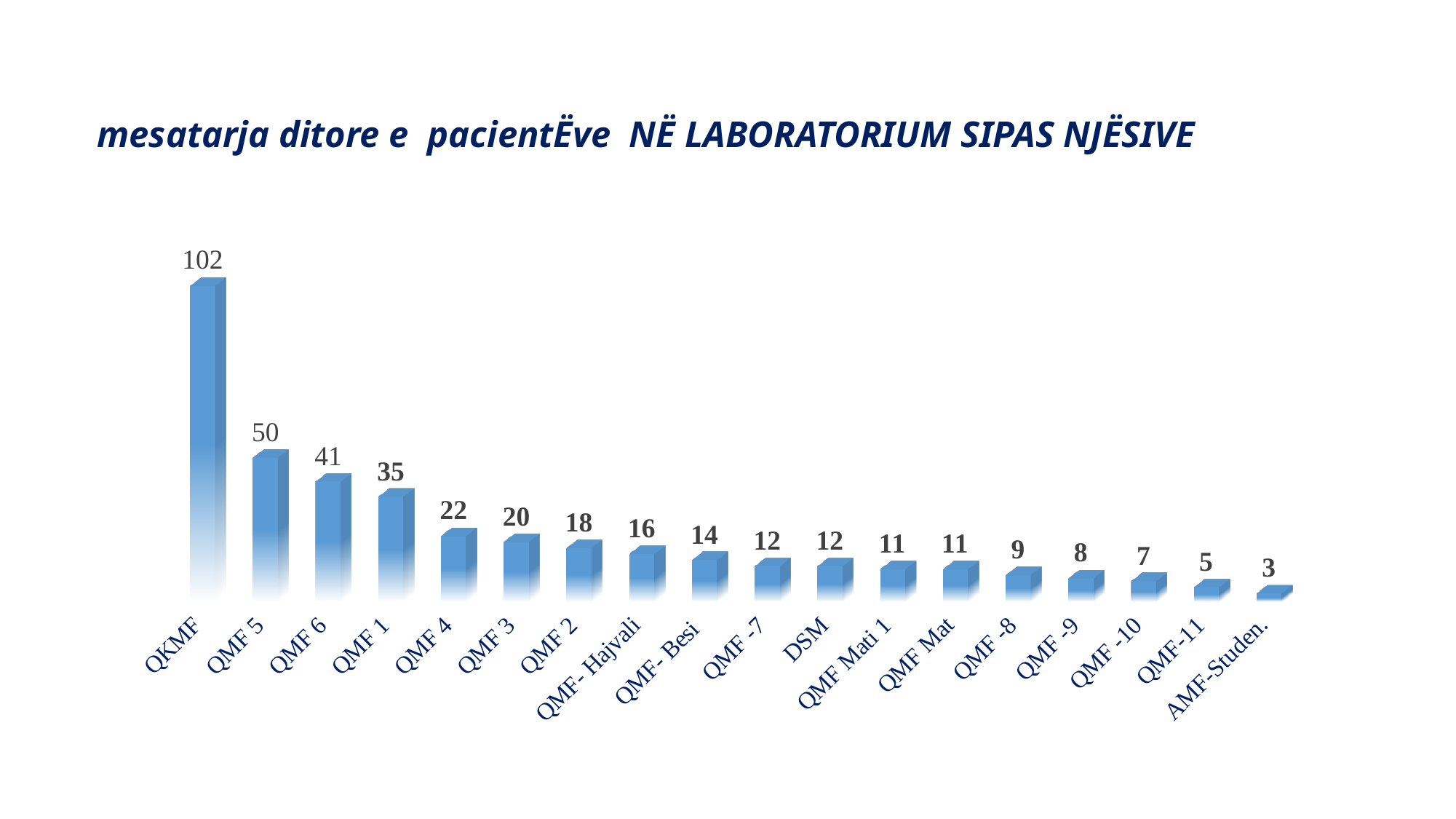
What is the difference between the values for QKMF and QMF 1? 67 What is the value for QMF- Hajvali? 16 Which category has the highest value? QKMF What kind of chart is shown on the slide? Bar chart Which category has the lowest value? AMF-Studen. How many categories are shown in the chart? 18 What is the value for QMF -10? 7 What is the value for QKMF? 102 Which is larger, the value for QMF 4 or the value for QMF- Besi? QMF 4 What is the difference between the values for QMF 5 and QMF 6? 9 What is the value for DSM? 12 Do the values rise or fall from left to right along the x axis? Fall